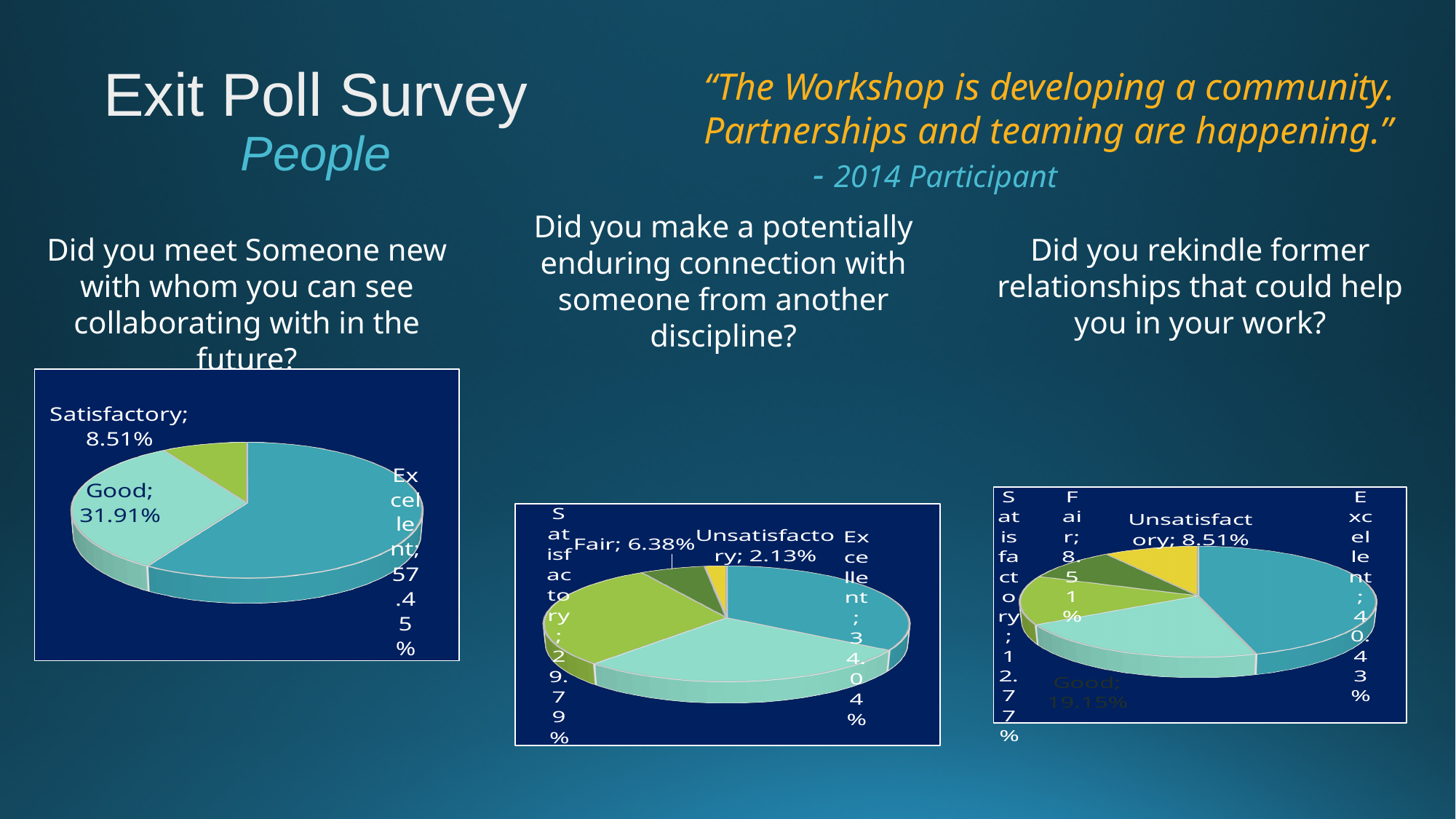
In the pie chart for "Did you make a potentially enduring connection with someone from another discipline?", what percentage is labelled Unsatisfactory? 2.13% In the pie chart for "Did you meet Someone new with whom you can see collaborating with in the future?", what percentage is labelled Excellent? 57.45% In the pie chart for "Did you make a potentially enduring connection with someone from another discipline?", what percentage is labelled Excellent? 34.04% In the pie chart for "Did you meet Someone new with whom you can see collaborating with in the future?", which labelled category has the largest slice? Excellent What type of chart is used for the three survey questions on this slide? Pie chart In the pie chart for "Did you rekindle former relationships that could help you in your work?", what percentage is labelled Excellent? 40.43% In the pie chart for "Did you meet Someone new with whom you can see collaborating with in the future?", what percentage is labelled Satisfactory? 8.51% In the pie chart for "Did you make a potentially enduring connection with someone from another discipline?", what percentage is labelled Fair? 6.38% In the pie chart for "Did you meet Someone new with whom you can see collaborating with in the future?", what percentage is labelled Good? 31.91% In the pie chart for "Did you rekindle former relationships that could help you in your work?", what percentage is labelled Satisfactory? 12.77% In the pie chart for "Did you make a potentially enduring connection with someone from another discipline?", which is larger, Satisfactory or Fair? Satisfactory In the pie chart for "Did you meet Someone new with whom you can see collaborating with in the future?", how many percentage points larger is Excellent than Good? 25.54%